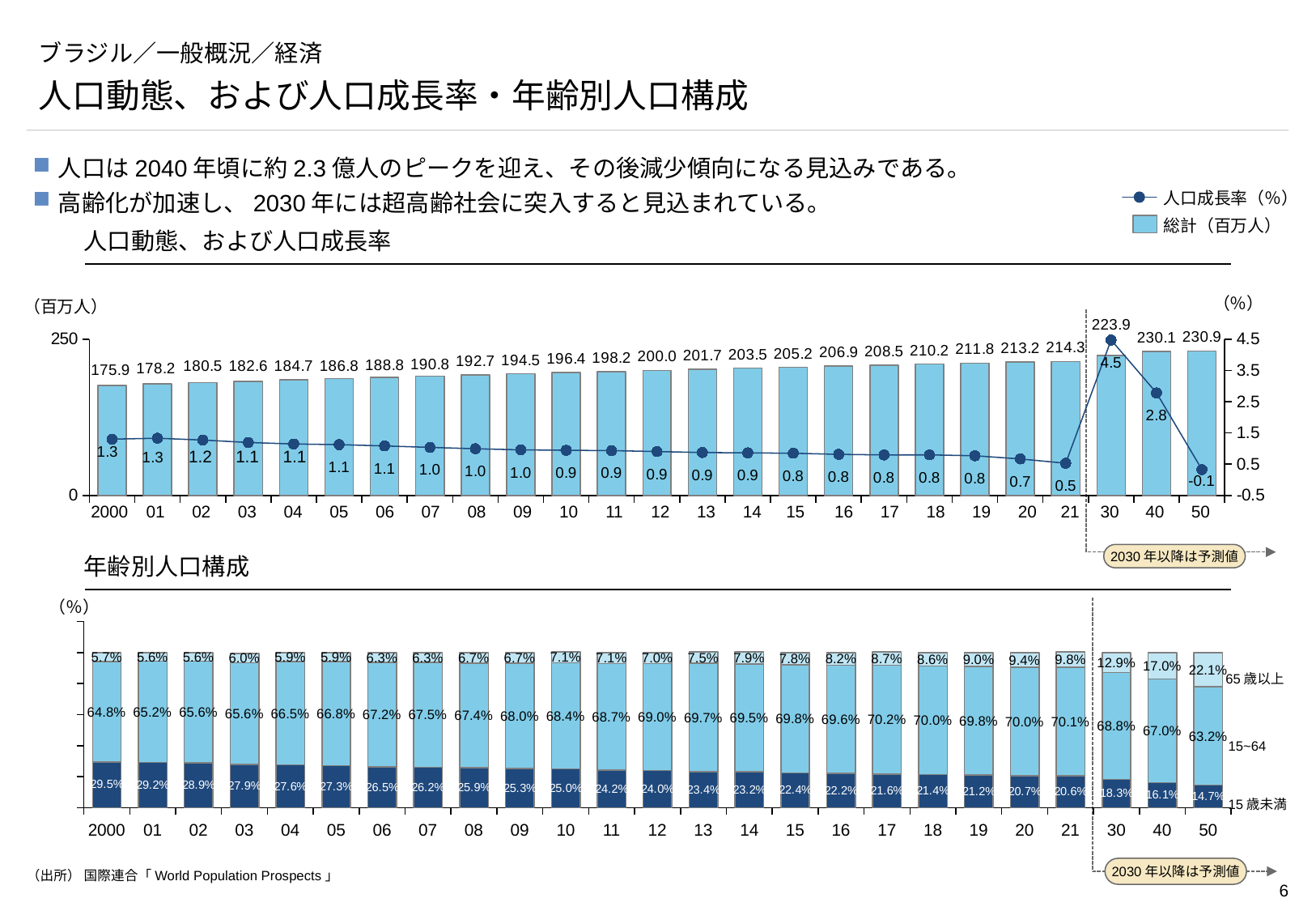
In the top chart (人口動態、および人口成長率), which year has the highest total population? 50 (2050) In the bottom chart (年齢別人口構成), what is the share of 65歳以上 in 2050? 22.1% How many series does the legend of the top chart list? 2 In the top chart (人口動態、および人口成長率), how many years are shown on the x axis? 25 In the bottom chart (年齢別人口構成), does the share of 65歳以上 rise or fall from 2000 to 2050? Rise In the top chart (人口動態、および人口成長率), is the population growth rate higher in 2030 or in 2040? 2030 What kind of chart is the bottom chart (年齢別人口構成)? Stacked bar chart In the top chart (人口動態、および人口成長率), which year has the lowest population growth rate? 50 (2050) In the bottom chart (年齢別人口構成), what is the share of 15歳未満 in 2000? 29.5% In the top chart (人口動態、および人口成長率), how much larger is the total population in 2050 than in 2000? 55.0 In the top chart (人口動態、および人口成長率), what is the total population (総計) for 2021? 214.3 In the top chart (人口動態、および人口成長率), what is the population growth rate (人口成長率) for 2030? 4.5